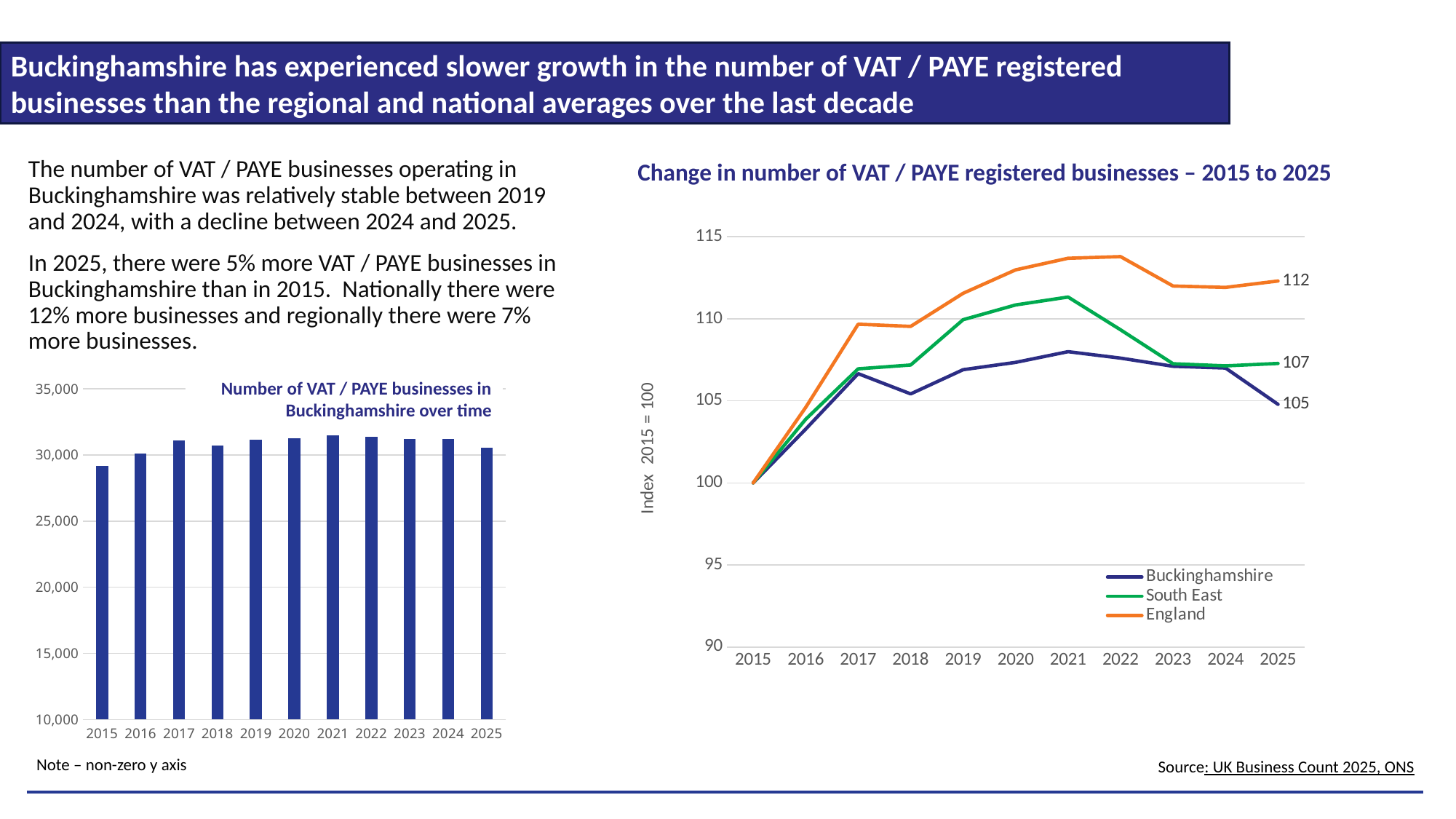
In the 'Change in number of VAT / PAYE registered businesses – 2015 to 2025' chart, what is the index value for South East in 2025? 107 In the 'Change in number of VAT / PAYE registered businesses – 2015 to 2025' chart, what is the index value for Buckinghamshire in 2025? 105 How many series does the legend of the 'Change in number of VAT / PAYE registered businesses – 2015 to 2025' chart list? 3 In the 'Change in number of VAT / PAYE registered businesses – 2015 to 2025' chart, which series has the lowest value in 2025? Buckinghamshire How many years are shown on the x axis of the 'Number of VAT / PAYE businesses in Buckinghamshire over time' chart? 11 What kind of chart is the 'Number of VAT / PAYE businesses in Buckinghamshire over time' chart? Bar chart In the 'Change in number of VAT / PAYE registered businesses – 2015 to 2025' chart, what is the difference between the 2025 index values for England and Buckinghamshire? 7 What kind of chart is the 'Change in number of VAT / PAYE registered businesses – 2015 to 2025' chart? Line chart In the 'Change in number of VAT / PAYE registered businesses – 2015 to 2025' chart, which series has the highest value in 2025? England In the 'Number of VAT / PAYE businesses in Buckinghamshire over time' chart, is the value for 2015 greater or less than 30,000? less In the 'Change in number of VAT / PAYE registered businesses – 2015 to 2025' chart, what is the index value for England in 2025? 112 In the 'Change in number of VAT / PAYE registered businesses – 2015 to 2025' chart, does the Buckinghamshire line rise or fall between 2022 and 2025? Fall